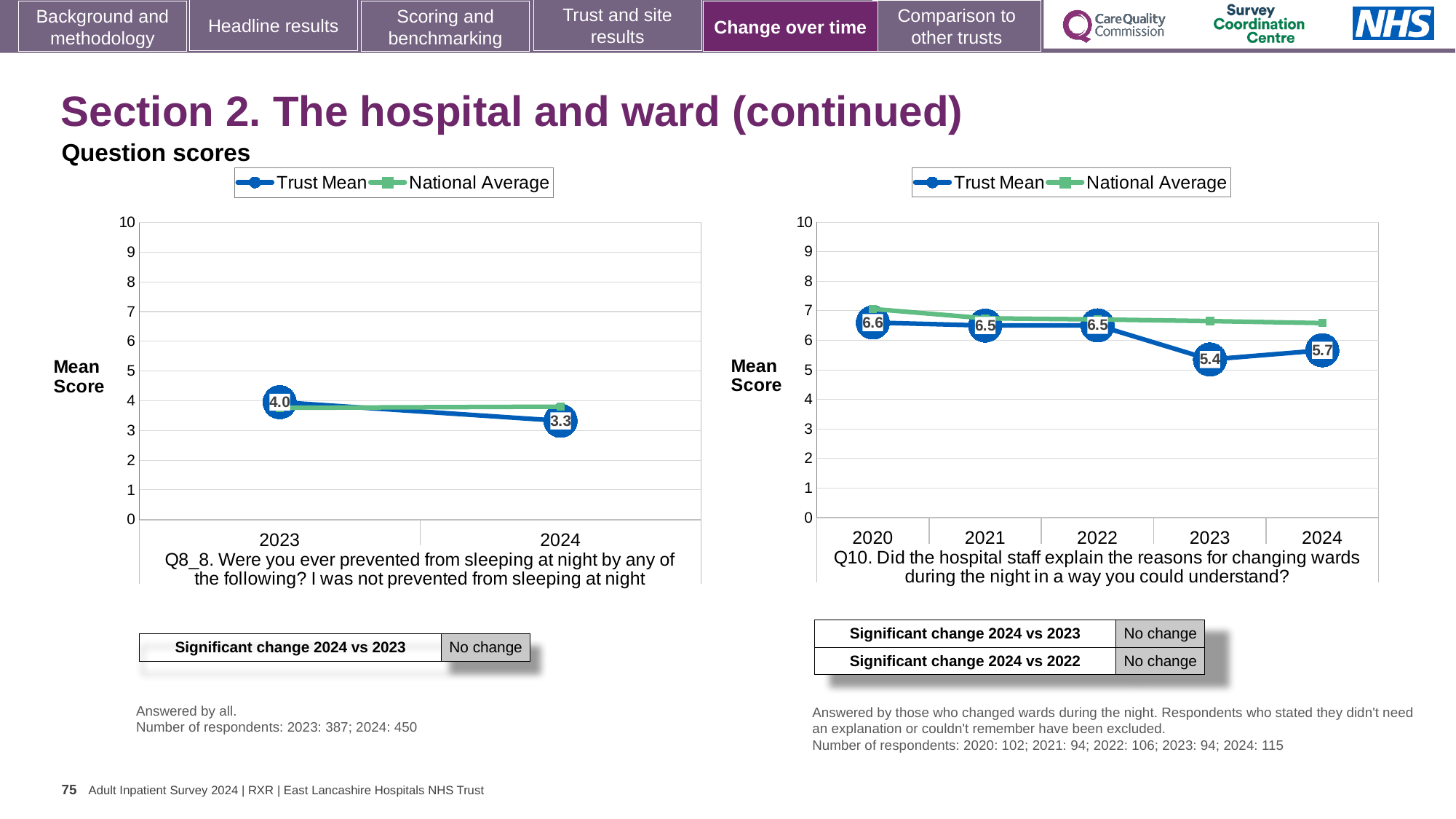
In the right chart (Q10), what is the Trust Mean score for 2023? 5.4 How many series does the legend of the left chart (Q8_8) list? 2 In the right chart (Q10), what is the difference between the Trust Mean scores for 2024 and 2023? 0.3 In the right chart (Q10), which year has the highest Trust Mean score? 2020 In the left chart (Q8_8), what is the Trust Mean score for 2023? 4.0 In the right chart (Q10), is the National Average value for 2023 greater or less than 6? greater What kind of chart is the right chart (Q10)? Line chart In the left chart (Q8_8), by how much did the Trust Mean fall from 2023 to 2024? 0.7 In the right chart (Q10), how many years are plotted on the x axis? 5 In the left chart (Q8_8), what is the Trust Mean score for 2024? 3.3 In the right chart (Q10), which year has the lowest Trust Mean score? 2023 In the right chart (Q10), what is the Trust Mean score for 2020? 6.6